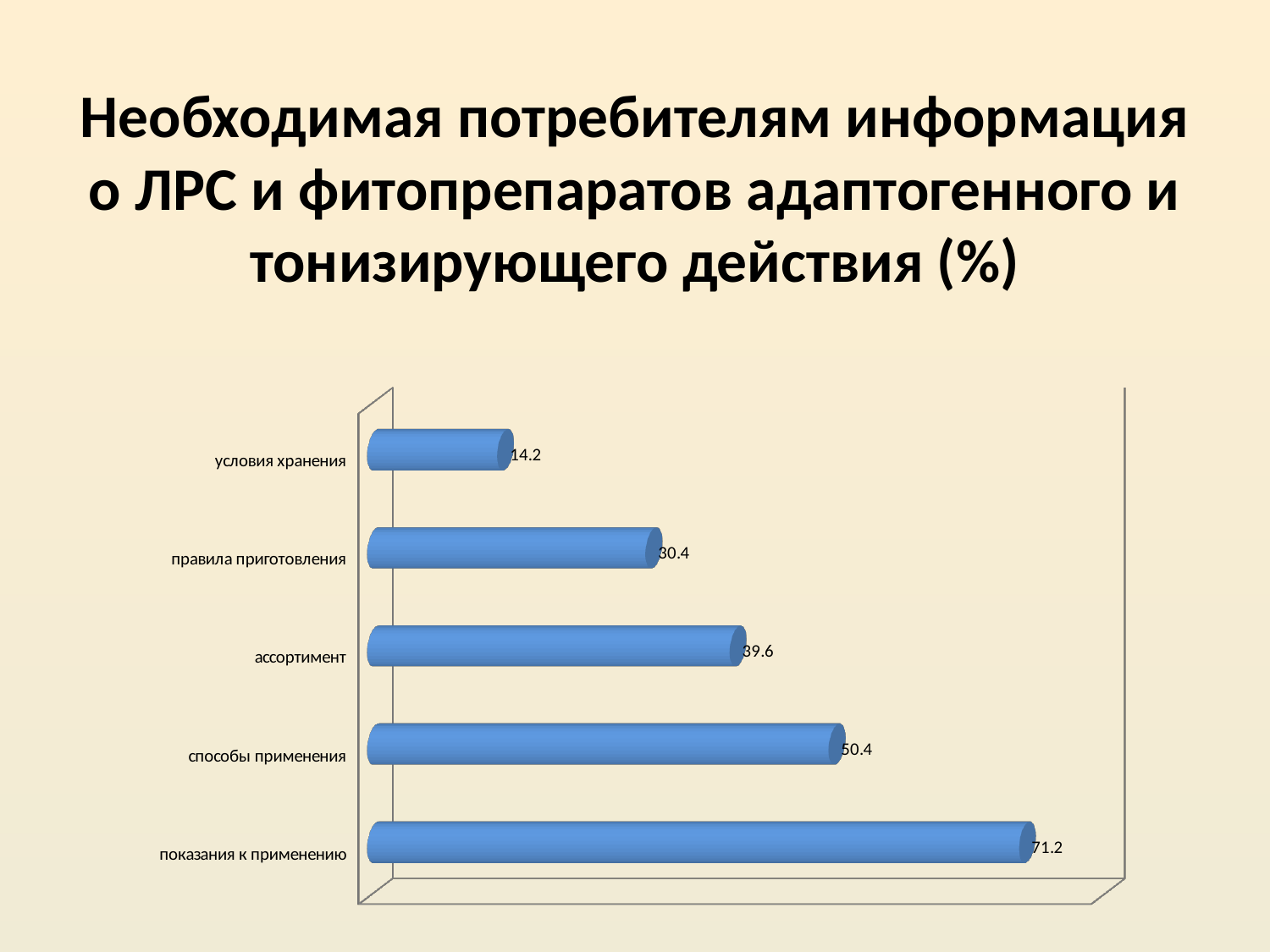
Which is larger, the value for правила приготовления or the value for ассортимент? ассортимент What is the difference between the values for ассортимент and условия хранения? 25.4 What is the difference between the values for показания к применению and способы применения? 20.8 What is the value for правила приготовления? 30.4 Which category has the highest value? показания к применению What is the value for способы применения? 50.4 How many categories are shown in the chart? 5 What is the value for условия хранения? 14.2 Which category has the lowest value? условия хранения What is the value for показания к применению? 71.2 What is the value for ассортимент? 39.6 What kind of chart is shown on the slide? bar chart